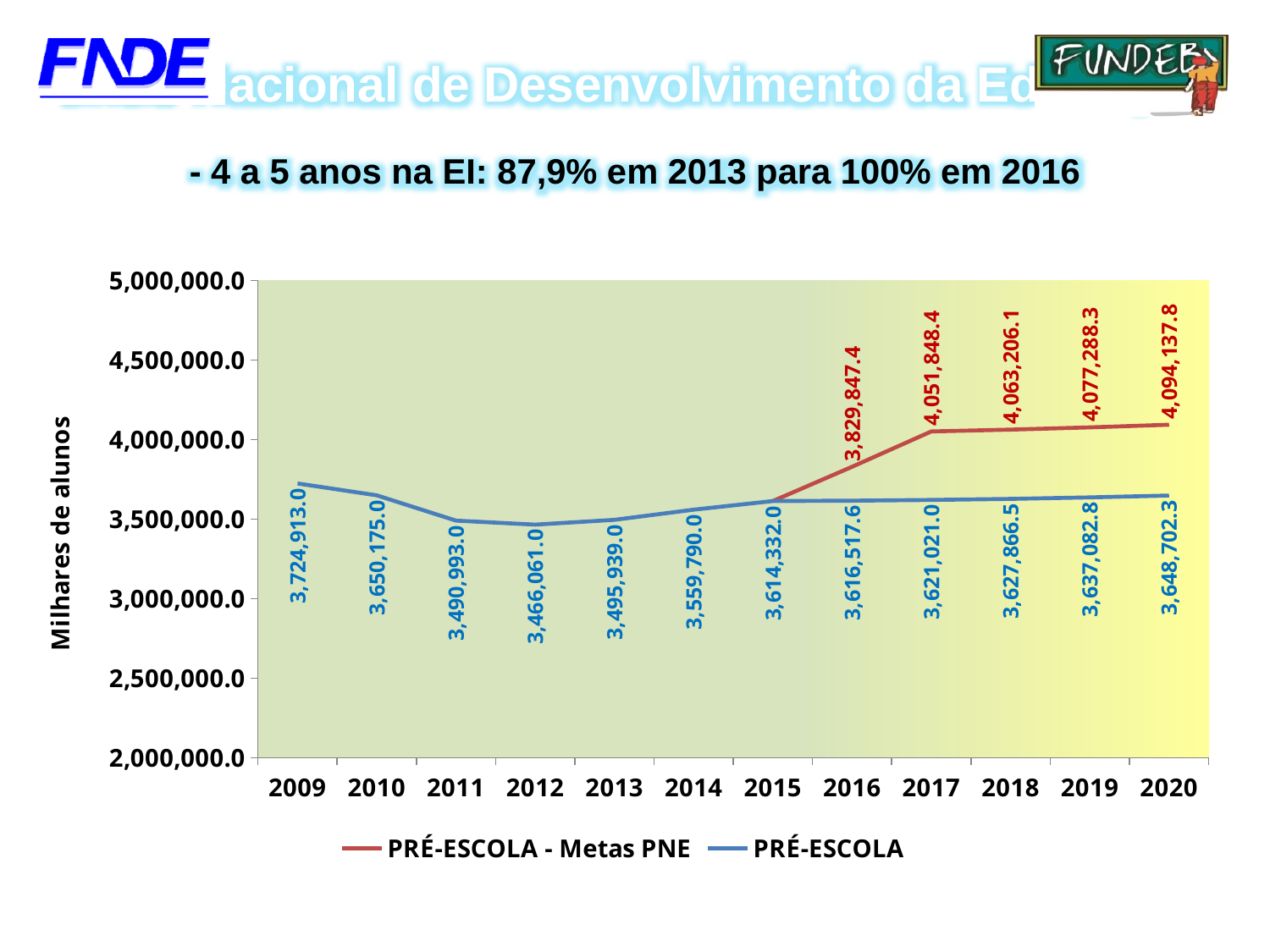
What is the difference between the PRÉ-ESCOLA - Metas PNE value and the PRÉ-ESCOLA value in 2020? 445,435.5 Is the PRÉ-ESCOLA - Metas PNE value in 2019 greater or less than 4,000,000.0? greater What is the value of the PRÉ-ESCOLA series in 2009? 3,724,913.0 In which year is the PRÉ-ESCOLA - Metas PNE series at its highest? 2020 What kind of chart is shown on the slide? line chart In which year is the PRÉ-ESCOLA series at its lowest? 2012 Does the PRÉ-ESCOLA - Metas PNE series rise or fall from 2016 to 2020? rise What is the value of the PRÉ-ESCOLA - Metas PNE series in 2017? 4,051,848.4 Which series has the larger value in 2018, PRÉ-ESCOLA - Metas PNE or PRÉ-ESCOLA? PRÉ-ESCOLA - Metas PNE How many series does the legend list? 2 What is the value of the PRÉ-ESCOLA series in 2020? 3,648,702.3 How many years are shown on the x axis? 12